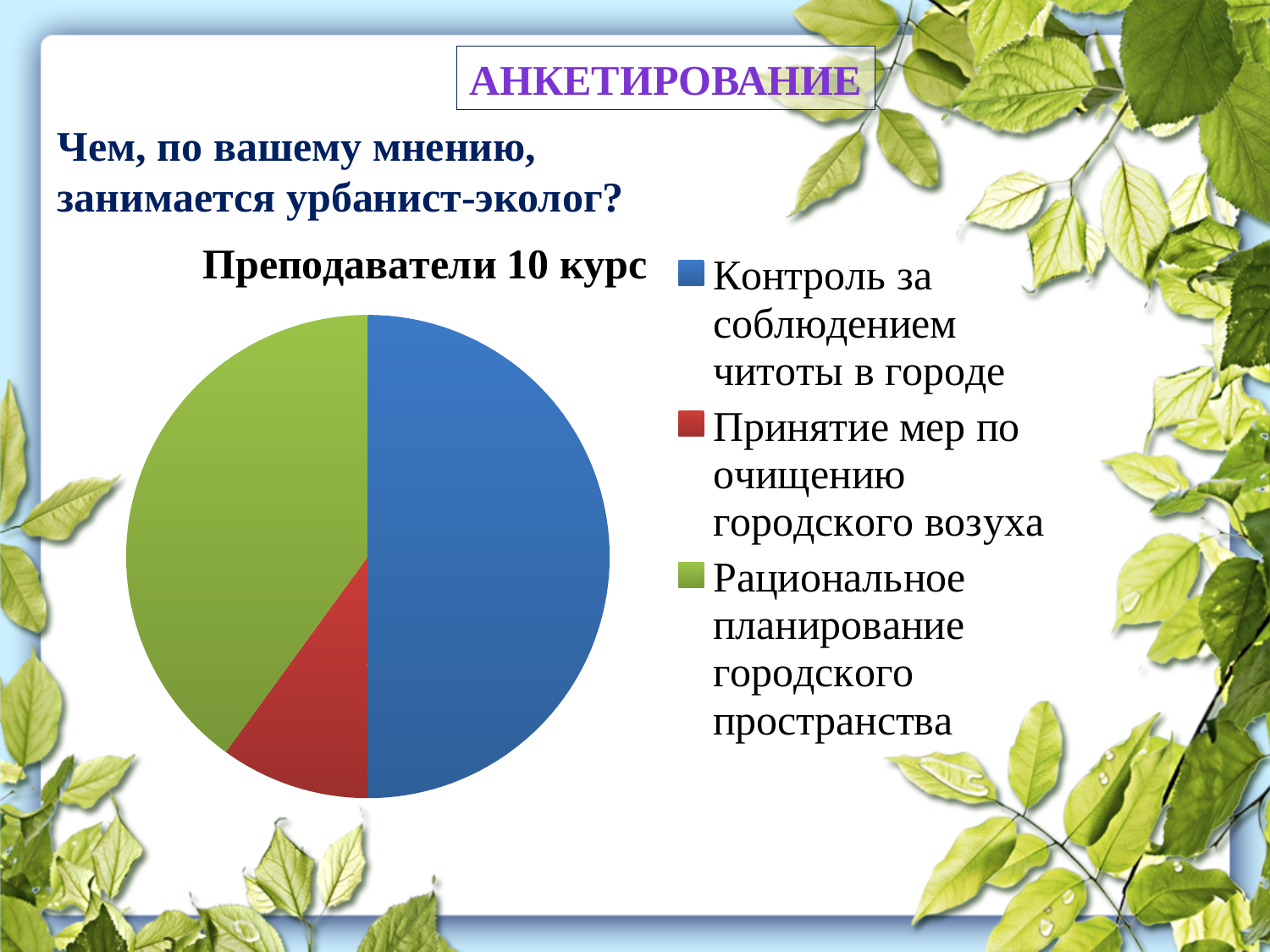
What colour is the slice for "Рациональное планирование городского пространства"? green Which category has the largest slice of the pie? Контроль за соблюдением читоты в городе Which slice is larger: "Рациональное планирование городского пространства" or "Принятие мер по очищению городского возуха"? Рациональное планирование городского пространства How many slices does the pie chart have? 3 How many entries does the legend list? 3 Which category has the smallest slice of the pie? Принятие мер по очищению городского возуха Which slice is larger: "Контроль за соблюдением читоты в городе" or "Рациональное планирование городского пространства"? Контроль за соблюдением читоты в городе What kind of chart is shown on the slide? pie chart What is the title of the chart? Преподаватели 10 курс